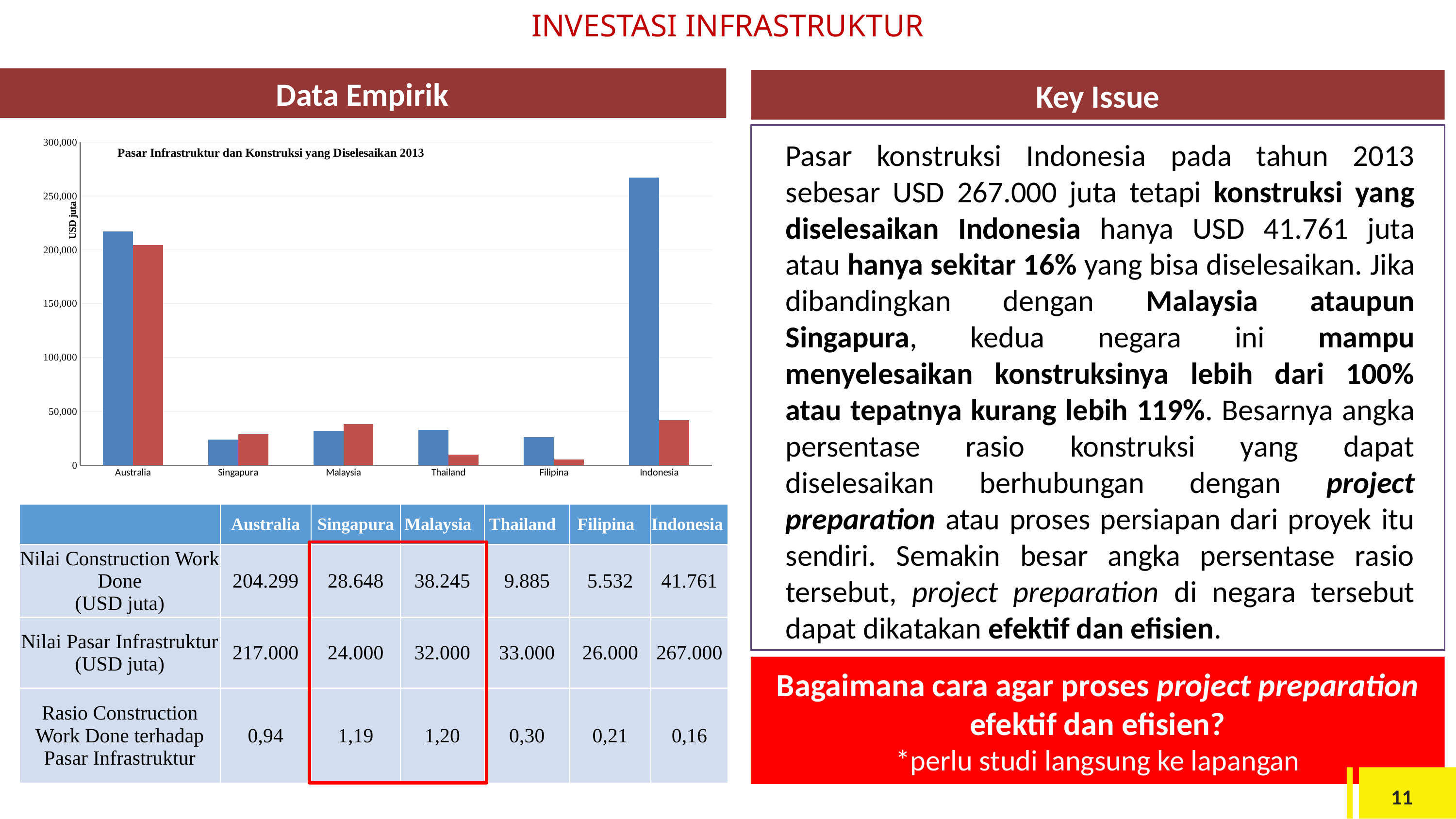
What is the label on the vertical axis of the chart? USD juta How many countries are shown on the x axis of the chart? 6 Is the value of the blue bar for Australia greater or less than 200,000? greater How many bars are plotted for each country in the chart? 2 Which is larger, the blue bar for Australia or the blue bar for Indonesia? Indonesia What kind of chart is shown on the slide? bar chart Is the value of the blue bar for Indonesia greater or less than 250,000? greater Is the value of the red bar for Indonesia greater or less than 50,000? less Which country has the tallest bar in the chart? Indonesia Which is larger, the red bar for Australia or the red bar for Indonesia? Australia What is the title of the chart? Pasar Infrastruktur dan Konstruksi yang Diselesaikan 2013